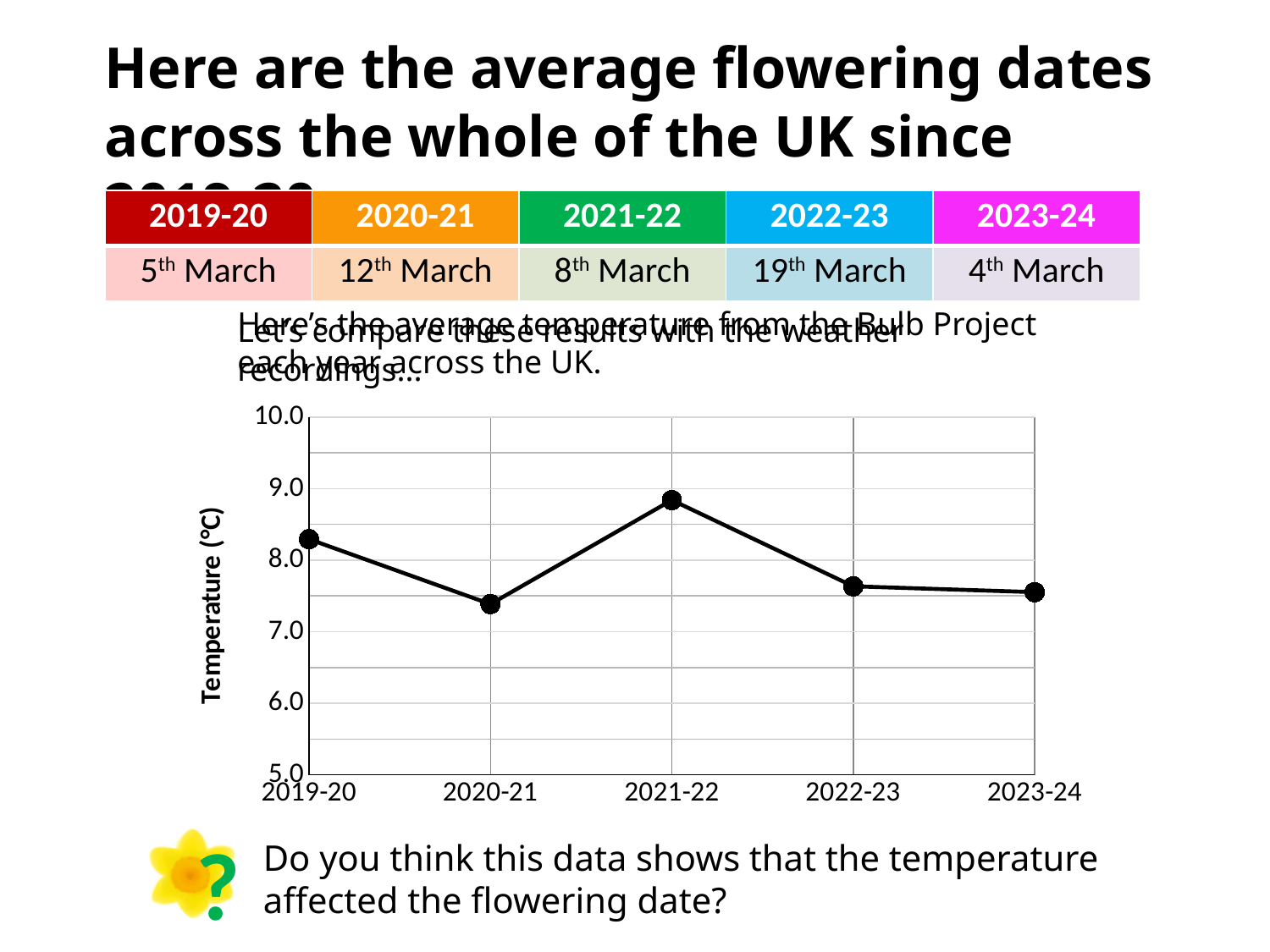
Which year has the highest temperature on the line chart? 2021-22 How many data points are plotted on the line chart? 5 Is the temperature for 2020-21 greater or less than 8.0? less Which has the higher temperature, 2019-20 or 2022-23? 2019-20 Is the temperature for 2022-23 greater or less than 8.0? less Is the temperature for 2019-20 greater or less than 8.0? greater Which has the higher temperature, 2021-22 or 2020-21? 2021-22 Does the temperature rise or fall from 2021-22 to 2023-24? fall What is the label on the vertical axis of the chart? Temperature (°C) What kind of chart is shown on the slide? line chart